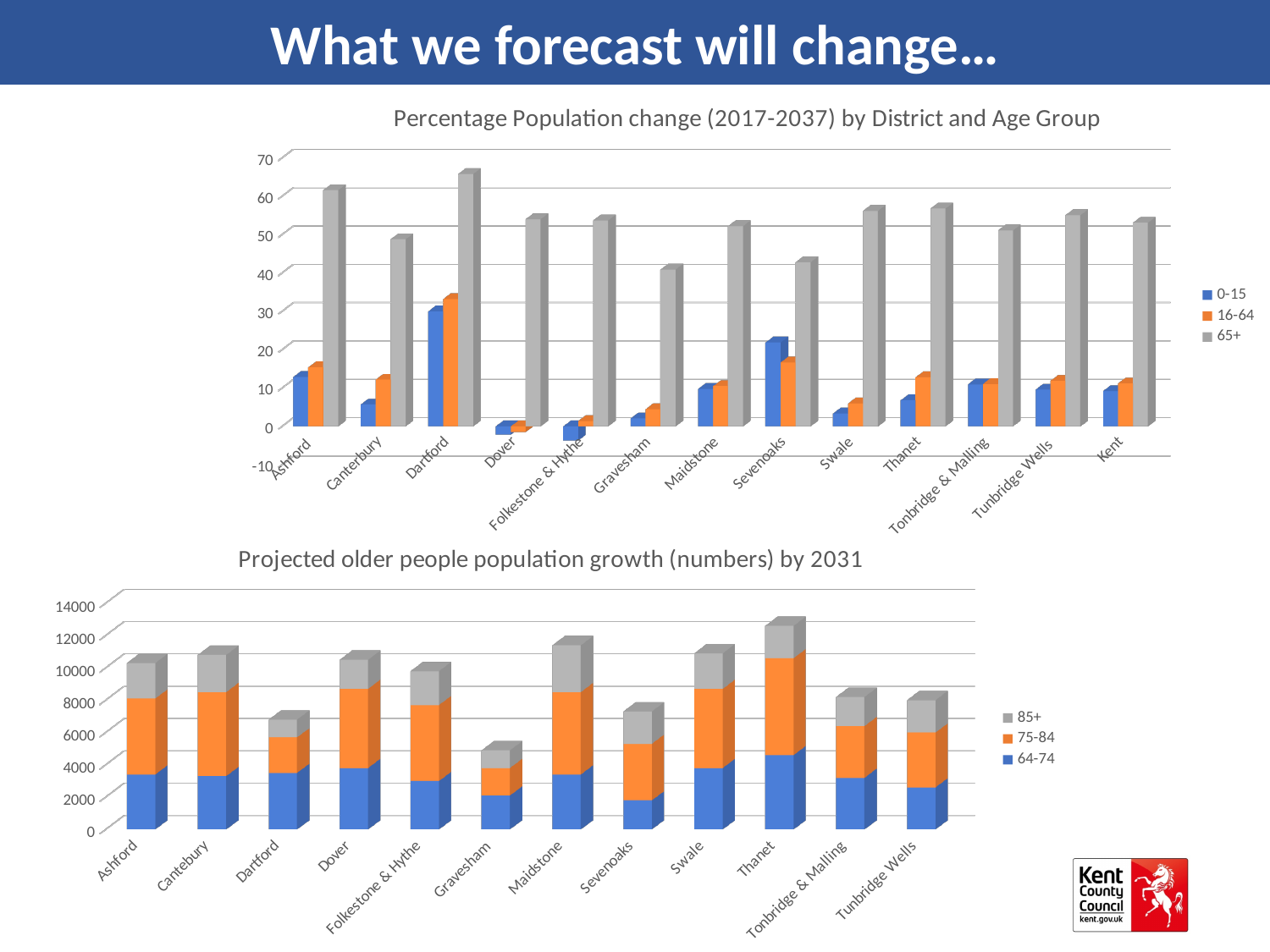
What are the three legend entries of the bottom chart? 85+, 75-84, 64-74 In the top chart, 'Percentage Population change (2017-2037) by District and Age Group', which district has the highest value for the 65+ series? Dartford In the bottom chart, 'Projected older people population growth (numbers) by 2031', which district has the shortest stacked bar? Gravesham In the bottom chart, is the total stacked bar for Thanet greater or less than 12000? greater In the top chart, is the 0-15 value for Dartford greater or less than 20? greater In the top chart, which is larger: the 0-15 value for Sevenoaks or the 0-15 value for Ashford? Sevenoaks What kind of chart is the bottom chart, 'Projected older people population growth (numbers) by 2031'? Stacked bar chart In the bottom chart, 'Projected older people population growth (numbers) by 2031', which district has the tallest stacked bar? Thanet How many categories are shown on the x axis of the top chart? 13 In the top chart, 'Percentage Population change (2017-2037) by District and Age Group', which district has the lowest value for the 65+ series? Gravesham In the top chart, is the 0-15 value for Dover greater or less than 0? less How many series does the legend of the top chart list? 3